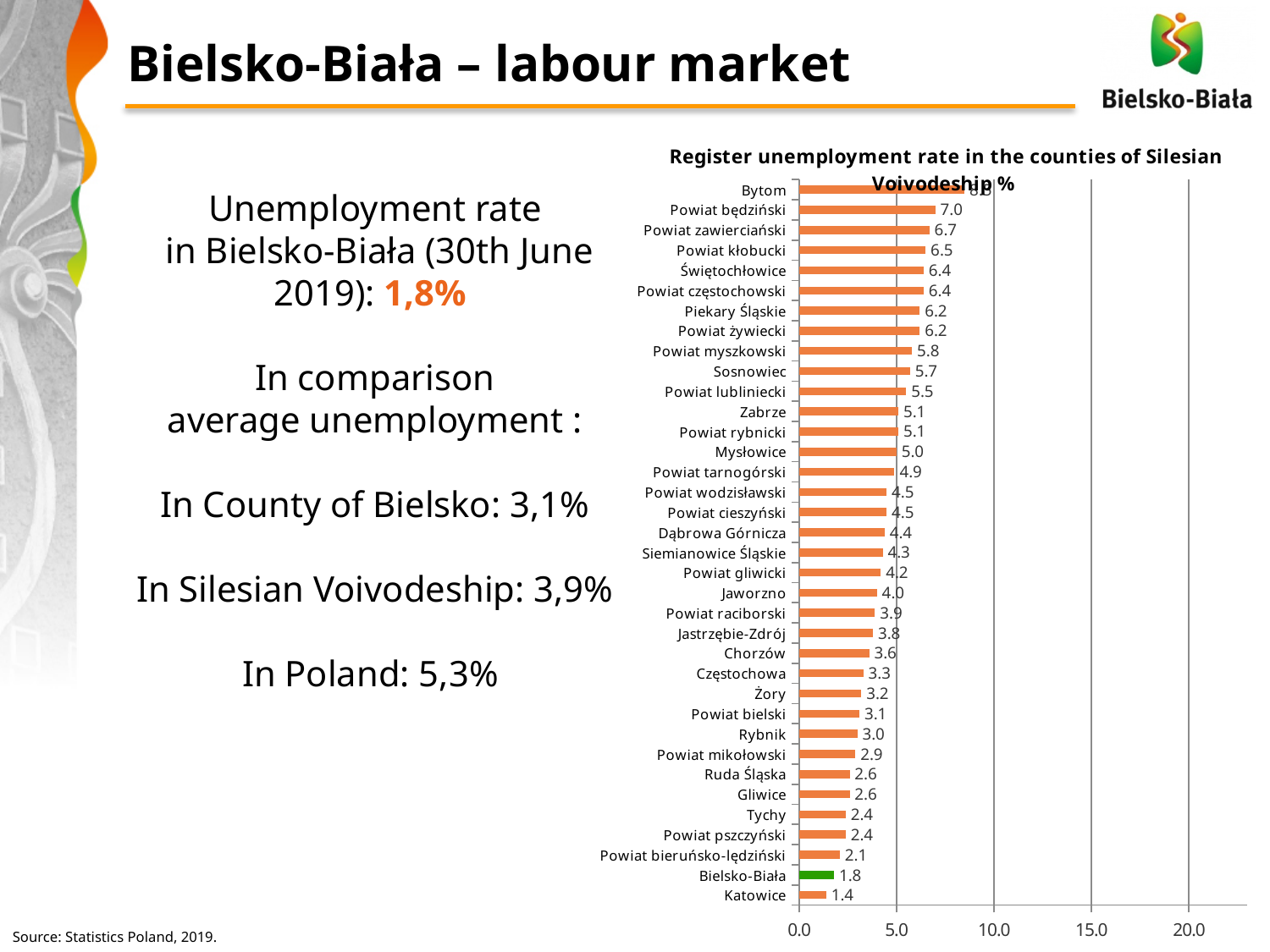
How many counties are listed in the chart? 36 What value is shown for Sosnowiec? 5.7 What value is shown for Powiat będziński? 7.0 What is the register unemployment rate shown for Katowice? 1.4 Which bar in the chart is coloured green instead of orange? Bielsko-Biała Which has a higher unemployment rate, Zabrze or Chorzów? Zabrze Is the value for Bytom greater or less than 5.0? greater Which county has the highest register unemployment rate in the chart? Bytom What kind of chart is shown on the slide? Bar chart What is the register unemployment rate shown for Bielsko-Biała? 1.8 What is the difference between the values for Powiat będziński and Bielsko-Biała? 5.2 Which county has the lowest register unemployment rate in the chart? Katowice